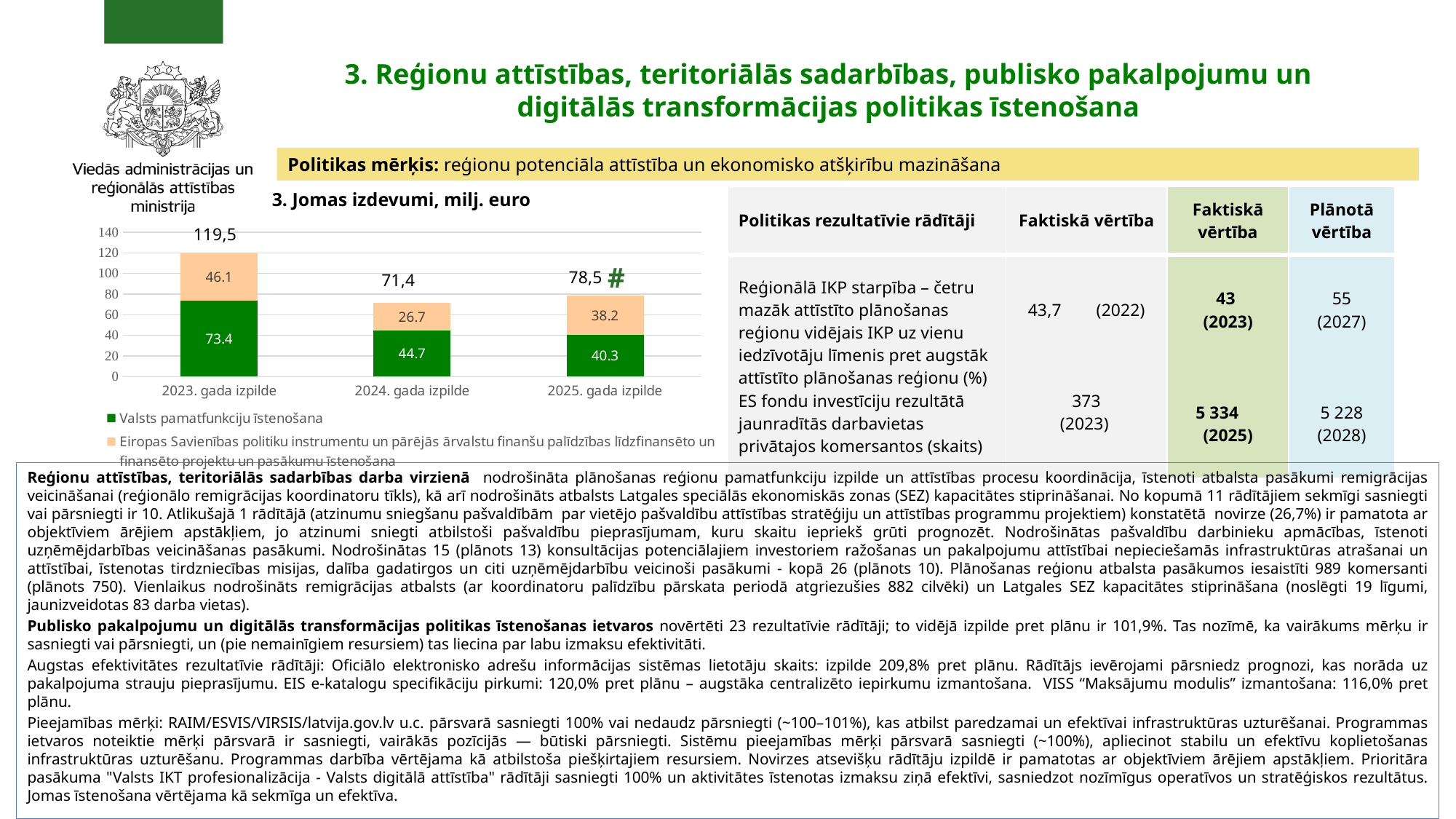
In the chart "3. Jomas izdevumi, milj. euro", is the Eiropas Savienības series value larger for 2025. gada izpilde or 2024. gada izpilde? 2025. gada izpilde In the chart "3. Jomas izdevumi, milj. euro", what is the difference between the Valsts pamatfunkciju īstenošana values for 2023. gada izpilde and 2024. gada izpilde? 28.7 In the chart "3. Jomas izdevumi, milj. euro", what is the total shown above the bar for 2023. gada izpilde? 119,5 What kind of chart is "3. Jomas izdevumi, milj. euro"? stacked bar chart In the chart "3. Jomas izdevumi, milj. euro", what is the value of Valsts pamatfunkciju īstenošana for 2025. gada izpilde? 40.3 How many categories are shown on the x axis of the chart "3. Jomas izdevumi, milj. euro"? 3 In the chart "3. Jomas izdevumi, milj. euro", which year has the lowest total expenditure? 2024. gada izpilde In the chart "3. Jomas izdevumi, milj. euro", what is the value of Valsts pamatfunkciju īstenošana for 2023. gada izpilde? 73.4 In the chart "3. Jomas izdevumi, milj. euro", what is the value of the Eiropas Savienības politiku instrumentu series for 2024. gada izpilde? 26.7 How many series does the legend of the chart "3. Jomas izdevumi, milj. euro" list? 2 In the chart "3. Jomas izdevumi, milj. euro", which year has the highest total expenditure? 2023. gada izpilde In the chart "3. Jomas izdevumi, milj. euro", what is the total shown above the bar for 2025. gada izpilde? 78,5